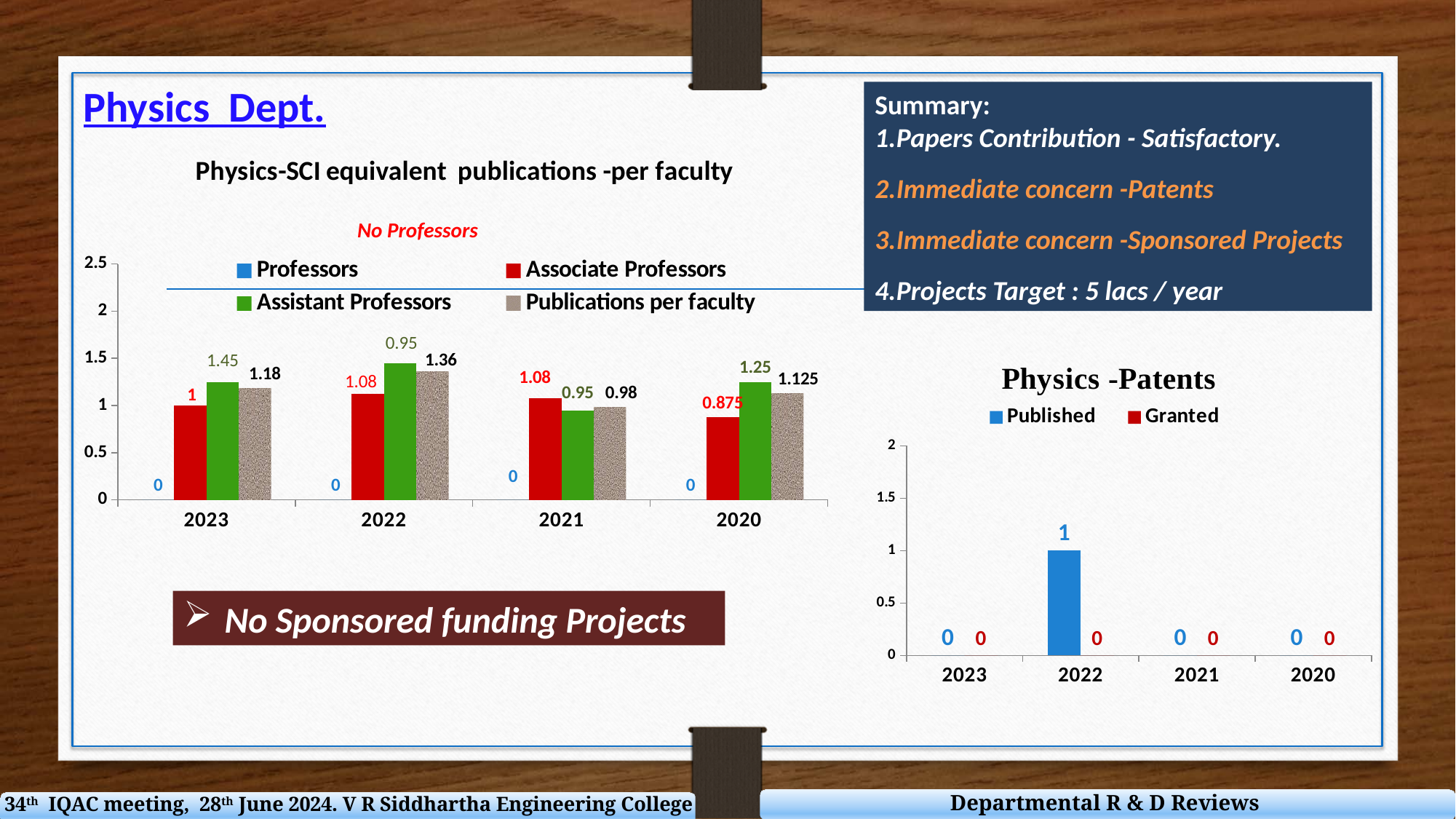
In the 'Physics-SCI equivalent publications -per faculty' chart, what is the value for Professors in 2023? 0 In the 'Physics-SCI equivalent publications -per faculty' chart, which year has the highest Publications per faculty? 2022 In the 'Physics -Patents' chart, which year has the highest Published value? 2022 In the 'Physics-SCI equivalent publications -per faculty' chart, what is the value for Associate Professors in 2020? 0.875 What kind of chart is the 'Physics -Patents' chart? Bar chart In the 'Physics-SCI equivalent publications -per faculty' chart, what is the value of Publications per faculty for 2022? 1.36 In the 'Physics -Patents' chart, what is the value for Published in 2022? 1 In the 'Physics-SCI equivalent publications -per faculty' chart, what is the difference between Publications per faculty in 2022 and 2021? 0.38 In the 'Physics-SCI equivalent publications -per faculty' chart, how many years are shown on the x axis? 4 In the 'Physics-SCI equivalent publications -per faculty' chart, which year has the lowest Publications per faculty? 2021 In the 'Physics-SCI equivalent publications -per faculty' chart, how many series does the legend list? 4 In the 'Physics -Patents' chart, what is the value for Granted in 2021? 0